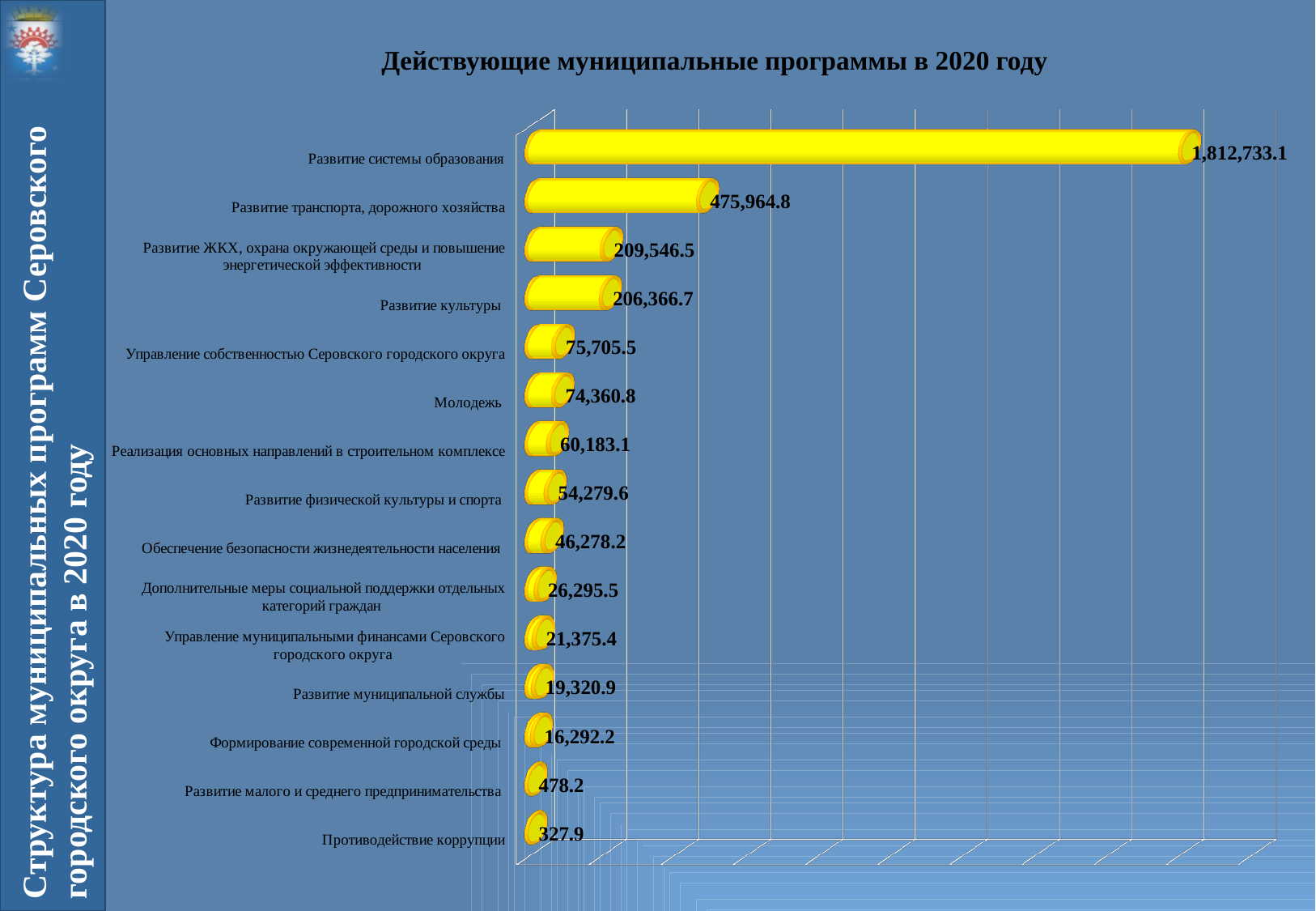
What is the title of the chart? Действующие муниципальные программы в 2020 году What is the difference between Развитие транспорта, дорожного хозяйства and Развитие ЖКХ, охрана окружающей среды и повышение энергетической эффективности? 266,418.3 How many programs are shown in the chart? 15 Which is larger: Управление собственностью Серовского городского округа or Молодежь? Управление собственностью Серовского городского округа What is the value for Развитие системы образования? 1,812,733.1 What is the value for Развитие культуры? 206,366.7 What is the value for Молодежь? 74,360.8 What is the difference between Развитие малого и среднего предпринимательства and Противодействие коррупции? 150.3 Which program has the lowest value? Противодействие коррупции What kind of chart is shown on the slide? Bar chart What is the value for Формирование современной городской среды? 16,292.2 Which program has the highest value? Развитие системы образования